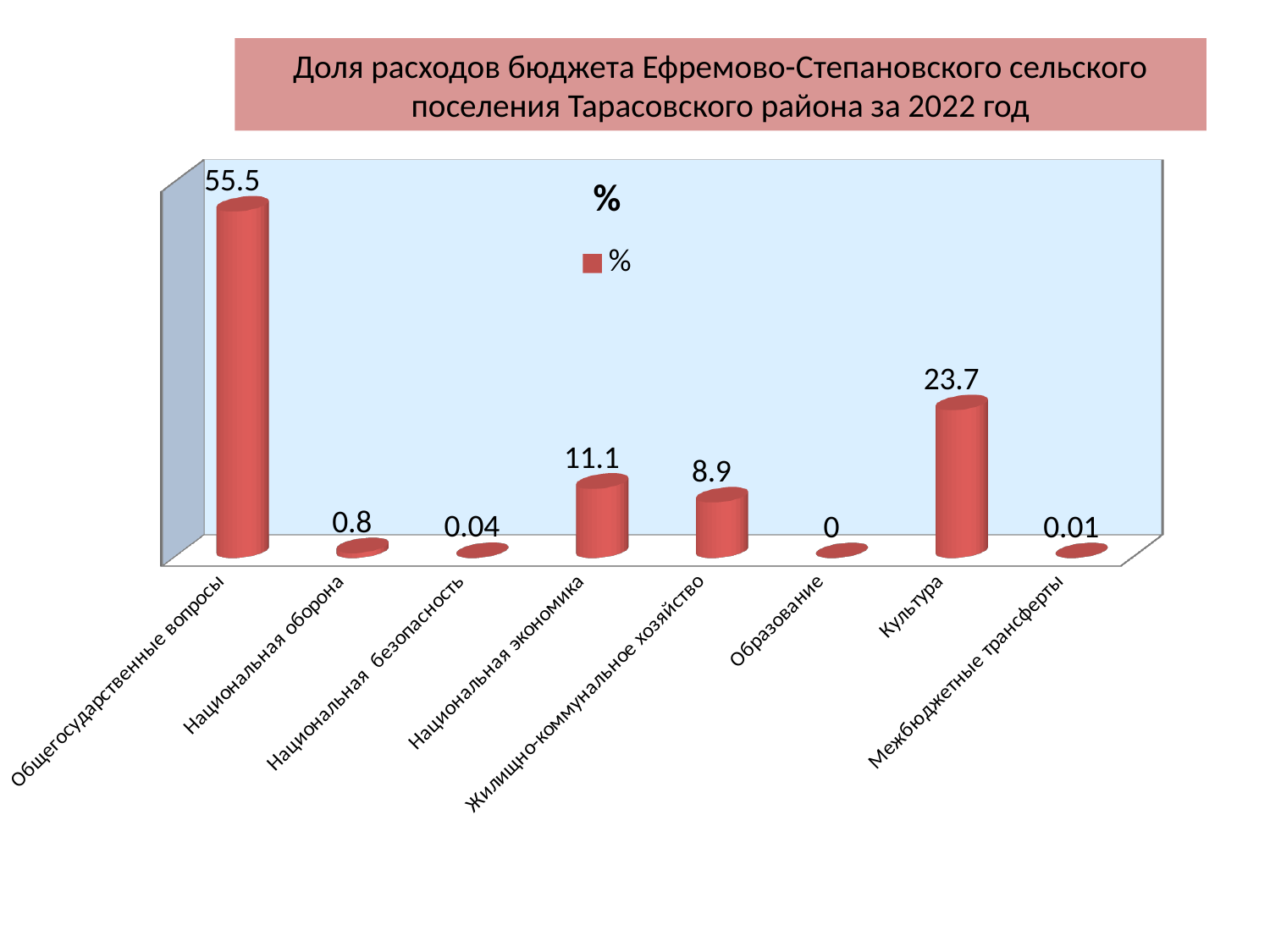
Which category has the lowest value? Образование What is the value for Культура? 23.7 How many series does the legend list? 1 What is the difference between the values for Общегосударственные вопросы and Культура? 31.8 What is the value for Национальная экономика? 11.1 What kind of chart is shown on the slide? bar chart Which is larger, the value for Национальная экономика or the value for Жилищно-коммунальное хозяйство? Национальная экономика What is the value for Общегосударственные вопросы? 55.5 How many categories are shown on the x axis? 8 Which category has the highest value? Общегосударственные вопросы What is the value for Межбюджетные трансферты? 0.01 What is the value for Жилищно-коммунальное хозяйство? 8.9